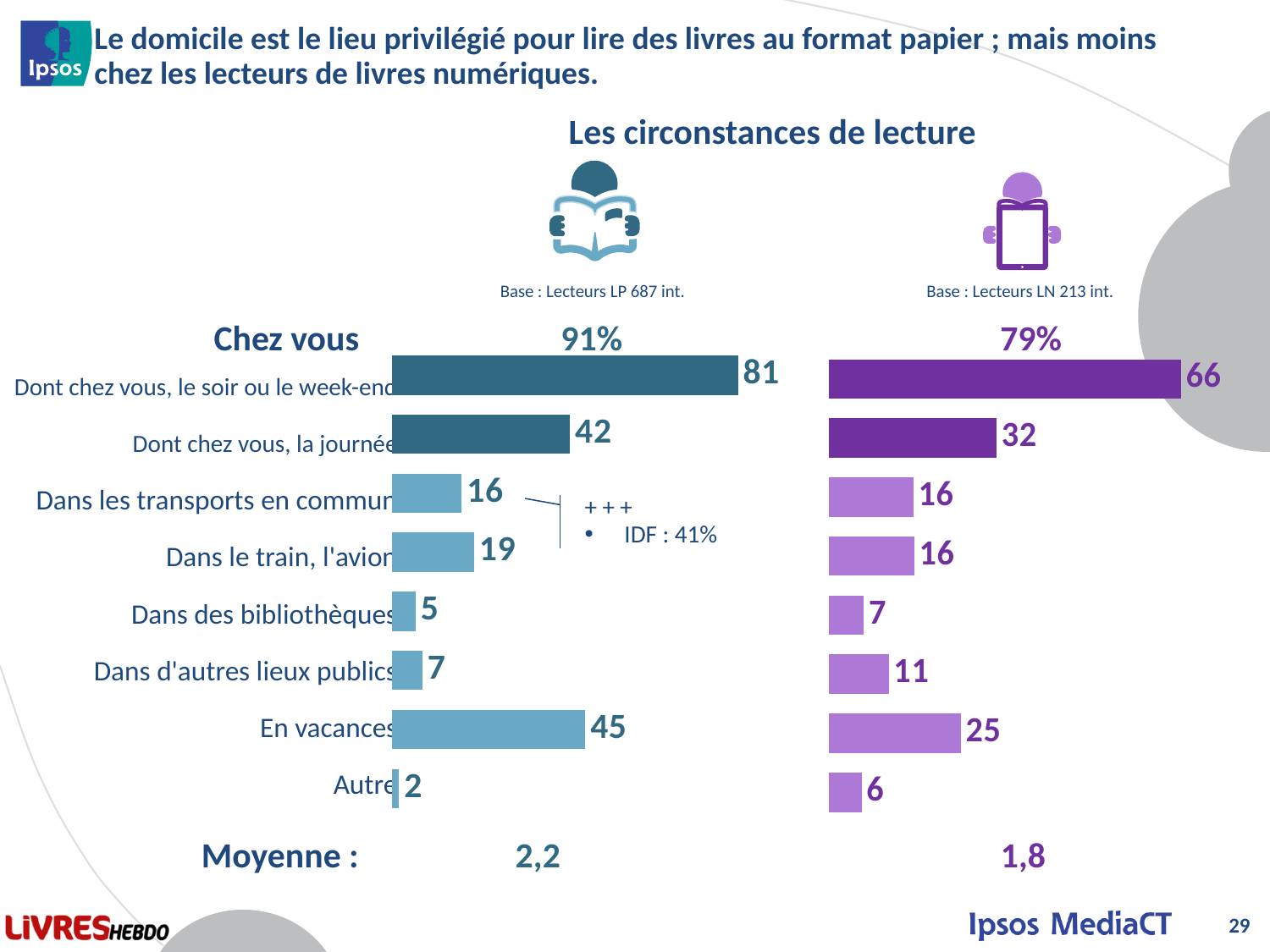
How many categories are plotted as bars in the left chart (Base : Lecteurs LP 687 int.)? 8 In the left chart (Base : Lecteurs LP 687 int.), which category has the highest value? Dont chez vous, le soir ou le week-end What is the difference between the values for "Dont chez vous, le soir ou le week-end" in the left chart and in the right chart? 15 In the right chart (Base : Lecteurs LN 213 int.), what is the value for "Dont chez vous, le soir ou le week-end"? 66 What is the "Chez vous" percentage shown above the right chart (Base : Lecteurs LN 213 int.)? 79% In the right chart (Base : Lecteurs LN 213 int.), what is the difference between "En vacances" and "Dans d'autres lieux publics"? 14 Which is larger: the value for "Dans des bibliothèques" in the left chart or in the right chart? Right chart (7) In the left chart (Base : Lecteurs LP 687 int.), which is larger: "Dans le train, l'avion" or "Dans les transports en commun"? Dans le train, l'avion In the left chart (Base : Lecteurs LP 687 int.), what is the value for "En vacances"? 45 In the left chart (Base : Lecteurs LP 687 int.), which category has the lowest value? Autre In the right chart (Base : Lecteurs LN 213 int.), which category has the lowest value? Autre What kind of chart is used on this slide? Bar chart